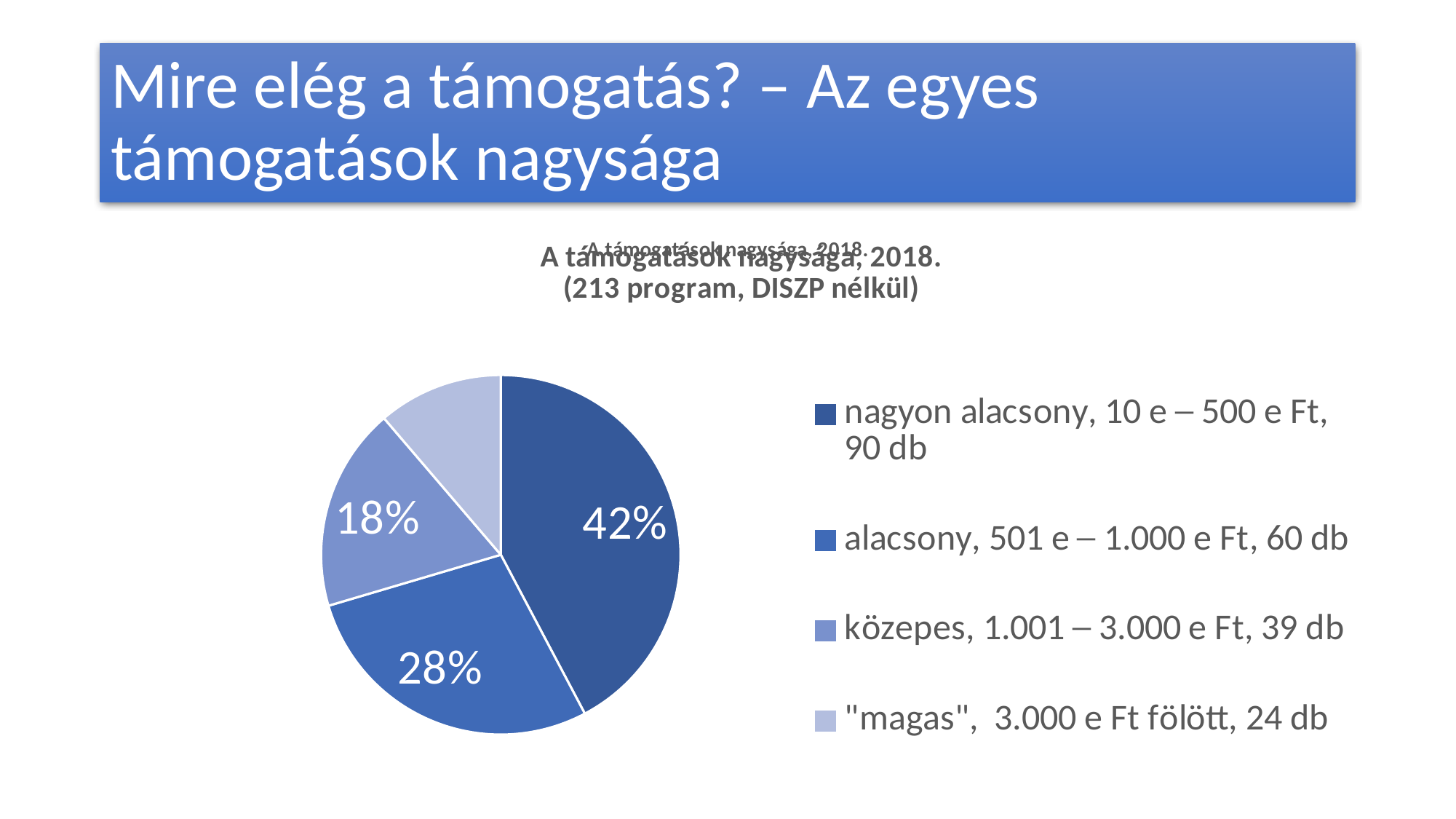
Which slice is larger: "alacsony, 501 e – 1.000 e Ft" or "közepes, 1.001 – 3.000 e Ft"? alacsony, 501 e – 1.000 e Ft Which category has the smallest slice of the pie? "magas", 3.000 e Ft fölött What percentage of the pie does the "közepes, 1.001 – 3.000 e Ft" slice represent? 18% What percentage of the pie does the "alacsony, 501 e – 1.000 e Ft" slice represent? 28% What is the difference in percentage points between the "nagyon alacsony" slice and the "alacsony" slice? 14 percentage points What kind of chart is shown on the slide? pie chart How many slices does the pie chart have? 4 Which category has the largest slice of the pie? nagyon alacsony, 10 e – 500 e Ft How many entries does the legend list? 4 According to the legend, how many programs (db) are in the "közepes, 1.001 – 3.000 e Ft" category? 39 db What is the title of the pie chart? A támogatások nagysága, 2018. (213 program, DISZP nélkül) What percentage of the pie does the "nagyon alacsony, 10 e – 500 e Ft" slice represent? 42%